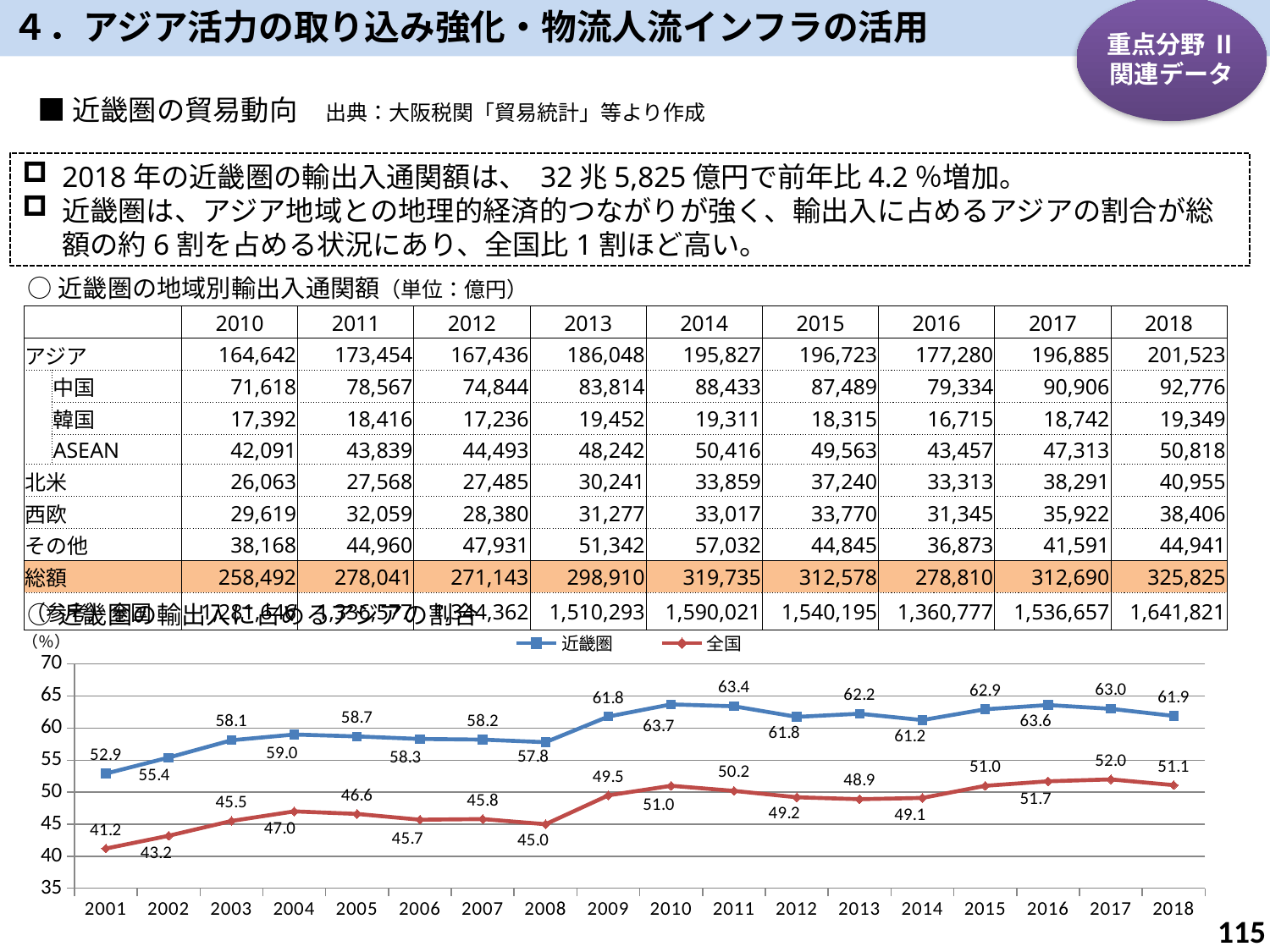
How many years are shown on the x axis of the line chart? 18 In 2009, which series has the higher value in the line chart, 近畿圏 or 全国? 近畿圏 In which year is the 近畿圏 series at its lowest in the line chart? 2001 In which year is the 全国 series at its lowest in the line chart? 2001 What is the value for 近畿圏 in 2001 in the line chart? 52.9 What is the difference between the 近畿圏 and 全国 values in 2018 in the line chart? 10.8 What is the value for 近畿圏 in 2018 in the line chart? 61.9 Does the 全国 series rise or fall from 2001 to 2004 in the line chart? rise What is the value for 全国 in 2010 in the line chart? 51.0 How many series does the legend of the line chart list? 2 Is the value for 近畿圏 in 2010 greater or less than 60? greater What kind of chart is shown at the bottom of the slide? line chart